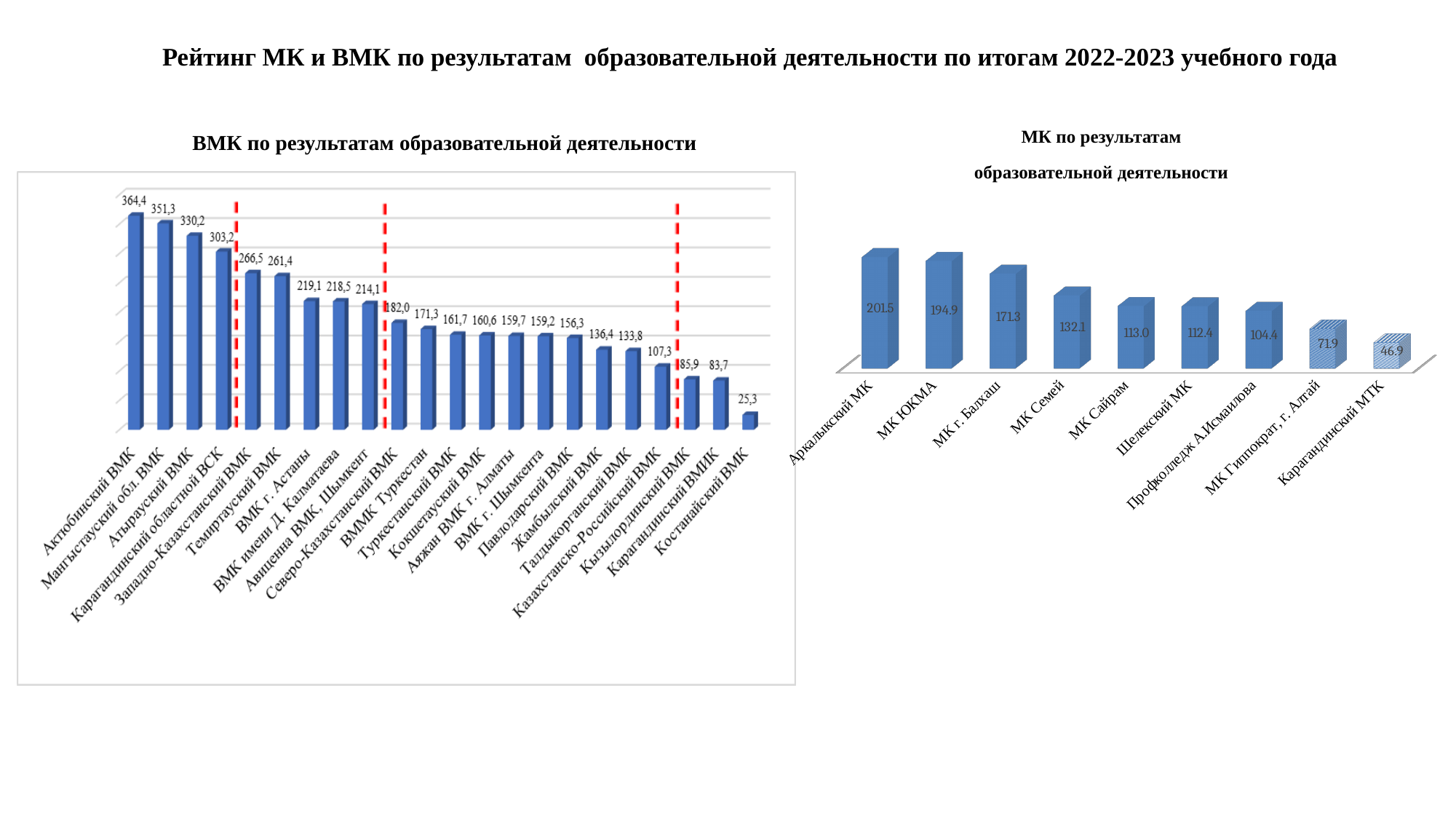
In the chart 'МК по результатам образовательной деятельности', what is the difference between Аркалыкский МК and МК ЮКМА? 6.6 What type of chart is 'МК по результатам образовательной деятельности'? Bar chart In the chart 'ВМК по результатам образовательной деятельности', what is the difference between Актюбинский ВМК and Мангыстауский обл. ВМК? 13,1 How many bars are plotted in the chart 'МК по результатам образовательной деятельности'? 9 In the chart 'ВМК по результатам образовательной деятельности', which is larger: Жамбылский ВМК or Казахстанско-Российский ВМК? Жамбылский ВМК In the chart 'МК по результатам образовательной деятельности', what is the value for Карагандинский МТК? 46.9 In the chart 'МК по результатам образовательной деятельности', which category has the highest value? Аркалыкский МК In the chart 'ВМК по результатам образовательной деятельности', which category has the lowest value? Костанайский ВМК In the chart 'МК по результатам образовательной деятельности', what is the value for МК Семей? 132.1 In the chart 'ВМК по результатам образовательной деятельности', what is the value for Актюбинский ВМК? 364,4 How many bars are plotted in the chart 'ВМК по результатам образовательной деятельности'? 22 In the chart 'ВМК по результатам образовательной деятельности', what is the value for Северо-Казахстанский ВМК? 182,0